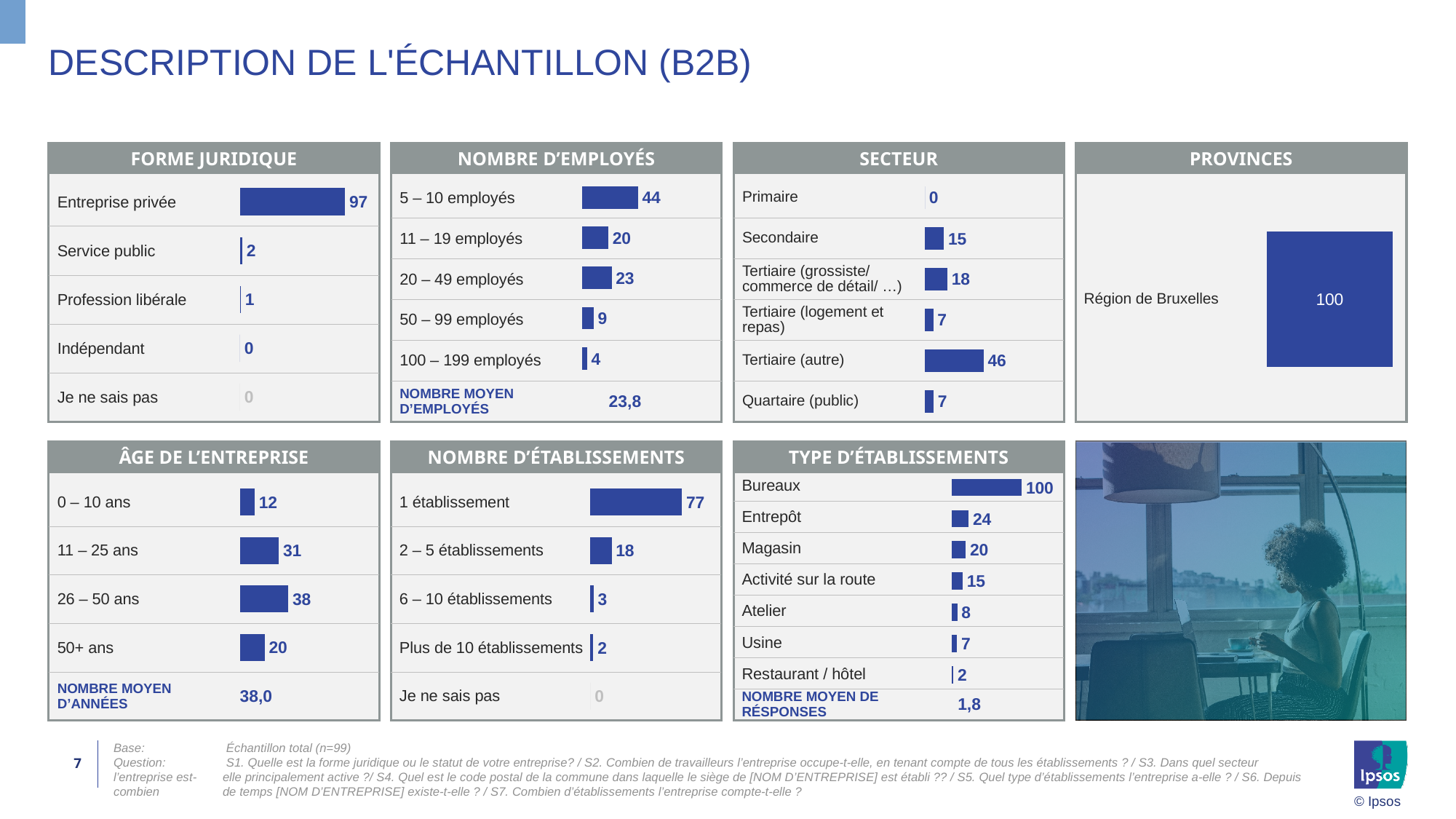
In the PROVINCES chart, what is the value for Région de Bruxelles? 100 In the FORME JURIDIQUE chart, what is the value for Entreprise privée? 97 What kind of chart is the NOMBRE D'ÉTABLISSEMENTS chart? Bar chart In the TYPE D'ÉTABLISSEMENTS chart, how many categories are shown? 7 In the ÂGE DE L'ENTREPRISE chart, which is larger: 11 – 25 ans or 26 – 50 ans? 26 – 50 ans In the NOMBRE D'ÉTABLISSEMENTS chart, what is the value for 1 établissement? 77 In the SECTEUR chart, which category has the lowest value? Primaire In the SECTEUR chart, what is the value for Tertiaire (autre)? 46 In the NOMBRE D'EMPLOYÉS chart, which category has the highest value? 5 – 10 employés In the TYPE D'ÉTABLISSEMENTS chart, what is the difference between Entrepôt and Magasin? 4 In the ÂGE DE L'ENTREPRISE chart, what is the NOMBRE MOYEN D'ANNÉES? 38,0 In the NOMBRE D'EMPLOYÉS chart, what is the difference between 20 – 49 employés and 11 – 19 employés? 3